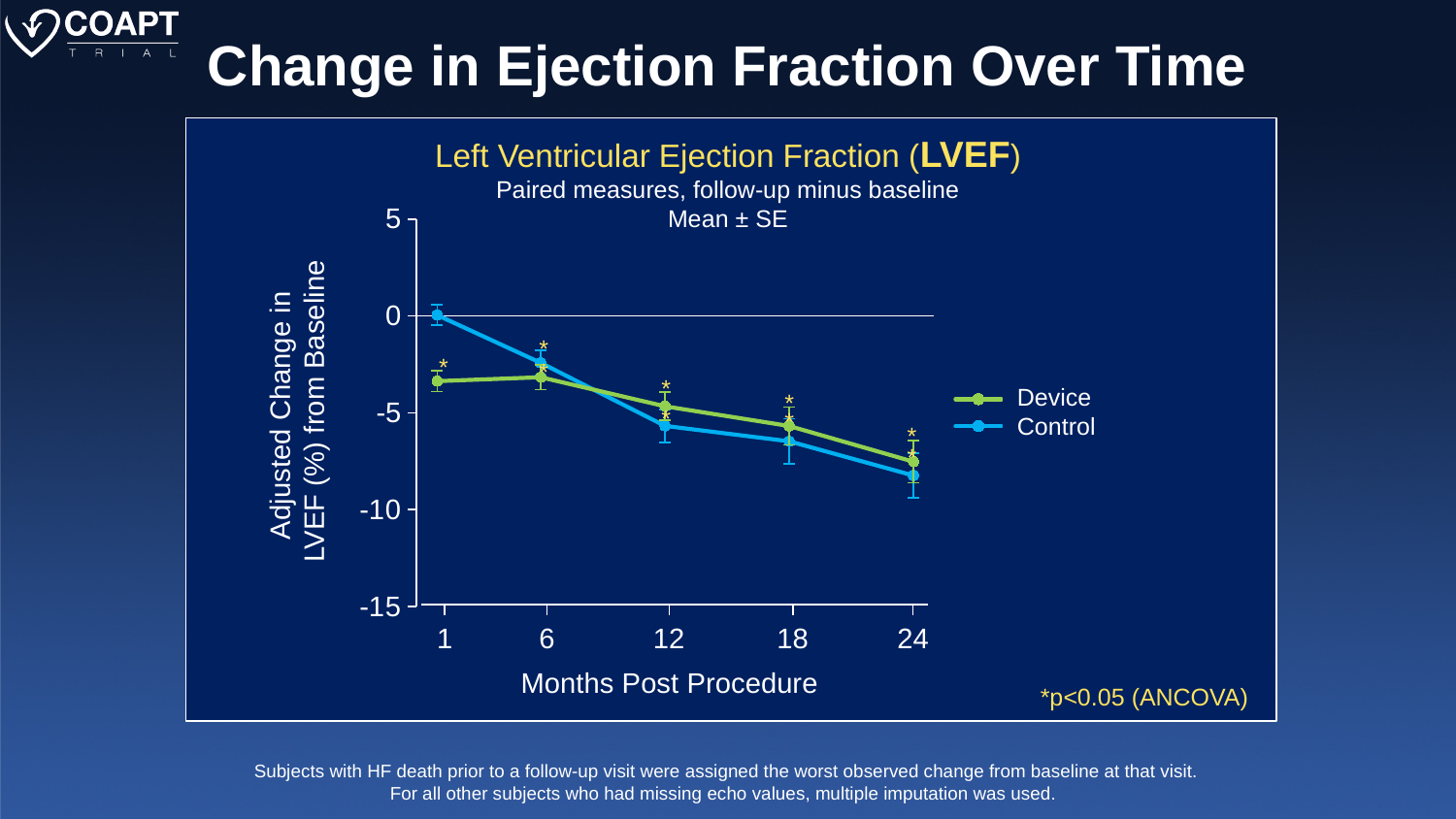
Which series is drawn in green? Device How many series does the legend list? 2 Is the value for Device at 24 months greater or less than -5? less What kind of chart is shown on the slide? line chart How many time points are plotted along the x axis? 5 Is the value for Control at 24 months greater or less than -10? greater Is the value for Device at 1 month greater or less than -5? greater At 12 months post procedure, which series has the higher value, Device or Control? Device At 1 month post procedure, which series has the higher value, Device or Control? Control What is the value for Control at 1 month post procedure? 0 Do the values for the Control series rise or fall from 1 month to 24 months? fall